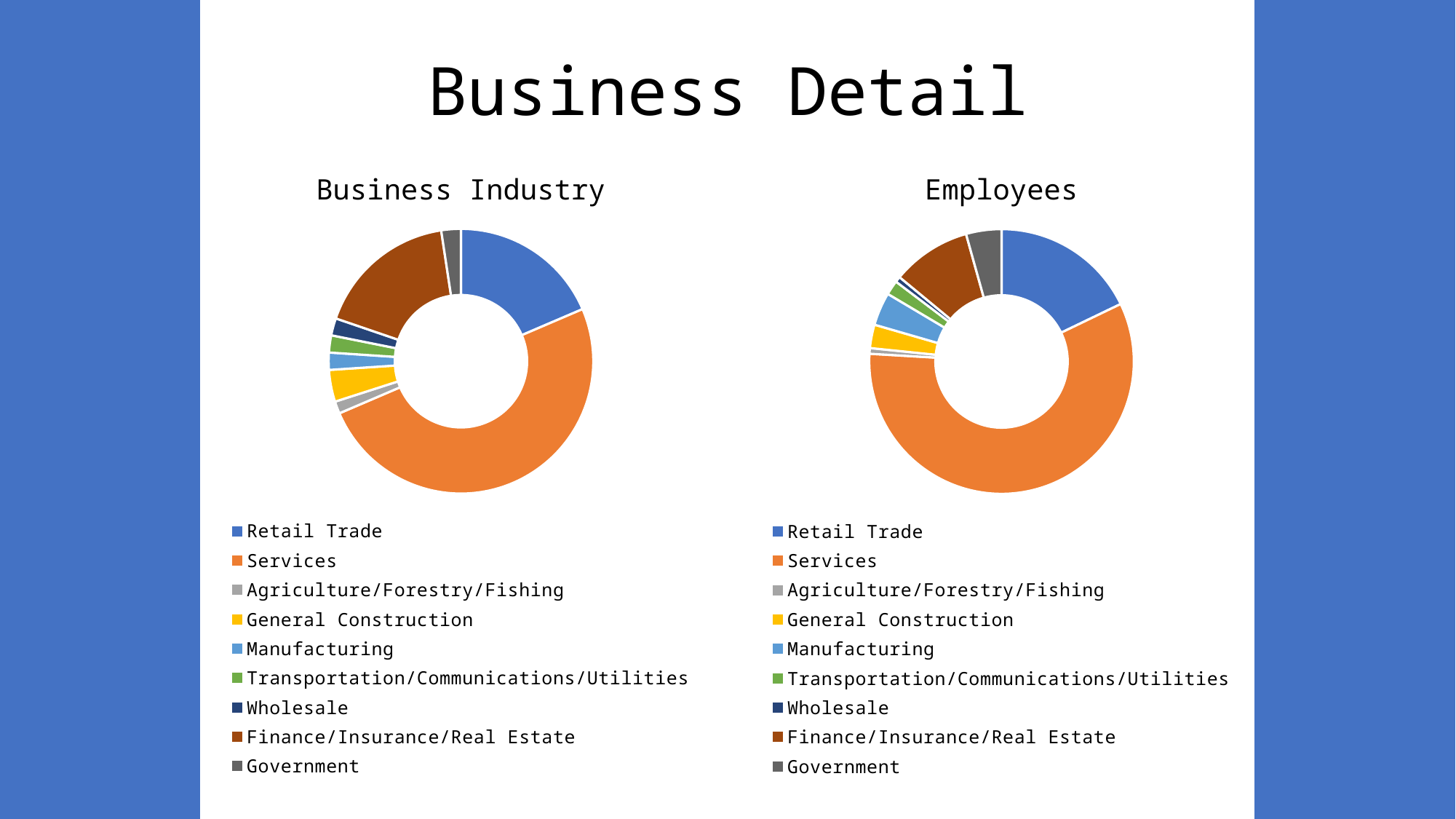
What is the title of the slide containing the two charts? Business Detail In the Business Industry chart, which is larger: General Construction or Agriculture/Forestry/Fishing? General Construction What kind of chart is the Business Industry chart? Doughnut (pie) chart In the Employees chart, which is larger: Retail Trade or Finance/Insurance/Real Estate? Retail Trade In the Employees chart, which category has the largest share? Services In the Employees chart, which is larger: Government or Wholesale? Government In the Business Industry chart, which category has the largest share? Services In the Employees chart, which colour represents Services? Orange What kind of chart is the Employees chart? Doughnut (pie) chart How many categories does the Business Industry chart's legend list? 9 How many categories does the Employees chart's legend list? 9